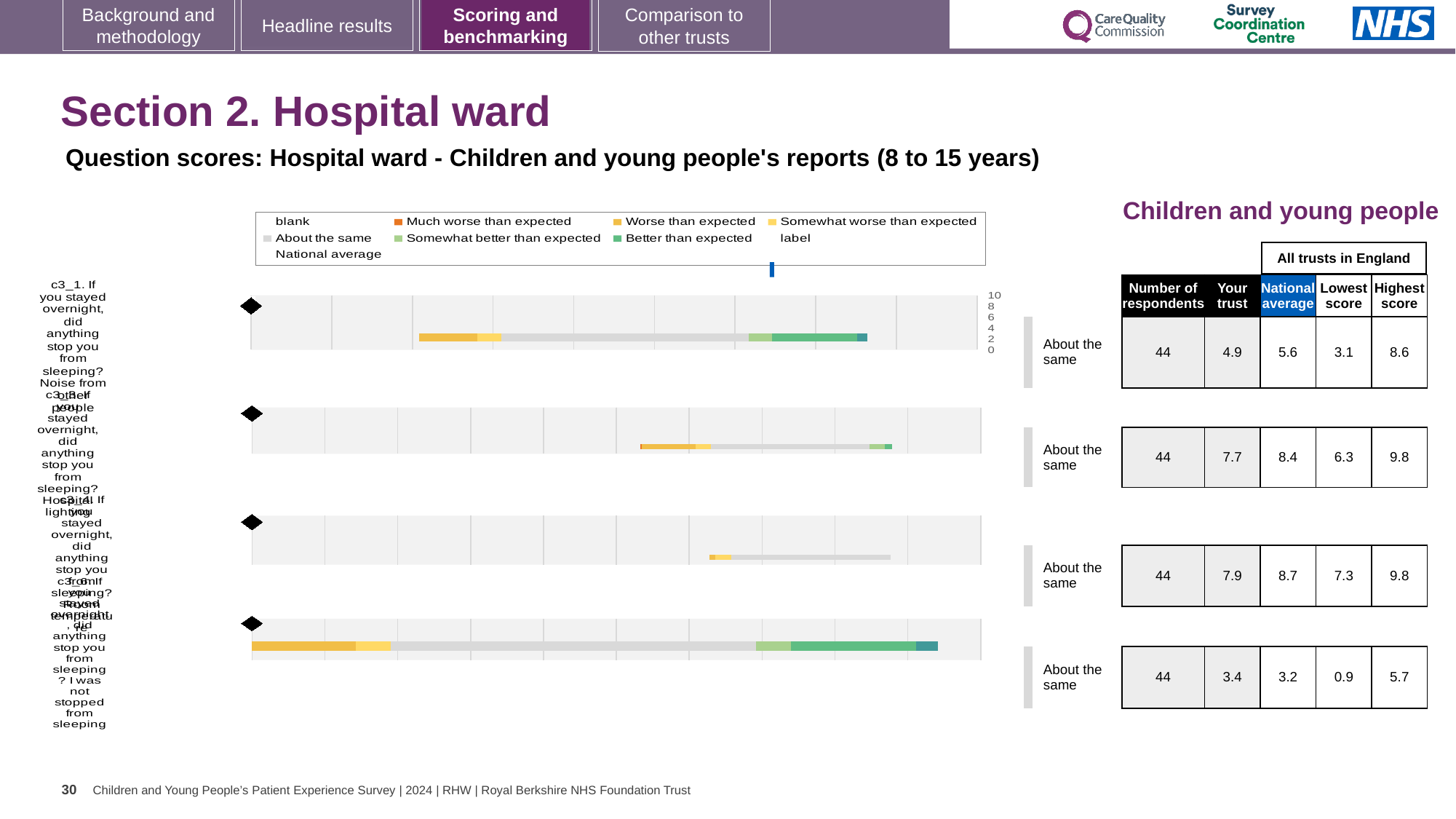
In the table next to the bottom chart, what is the lowest score across all trusts in England? 0.9 For the bottom chart, which is larger: the 'Your trust' score or the national average? Your trust (3.4) Which of the four charts has the lowest 'Your trust' score in the table? the bottom chart (3.4) In the table next to the top chart, what is the national average? 5.6 For the top chart, what is the difference between the highest score (8.6) and the lowest score (3.1) in the table? 5.5 How many respondents are listed for the third chart from the top? 44 What benchmark label is shown beside each of the four charts? About the same Which of the four charts has the highest 'Your trust' score in the table? the third chart from the top (7.9) In the table next to the second chart from the top, what is the highest score across all trusts in England? 9.8 In the table next to the top chart, what is the 'Your trust' score? 4.9 How many benchmarking bar charts are shown on the slide? 4 What kind of chart is used for the four benchmarking charts on the slide? bar chart